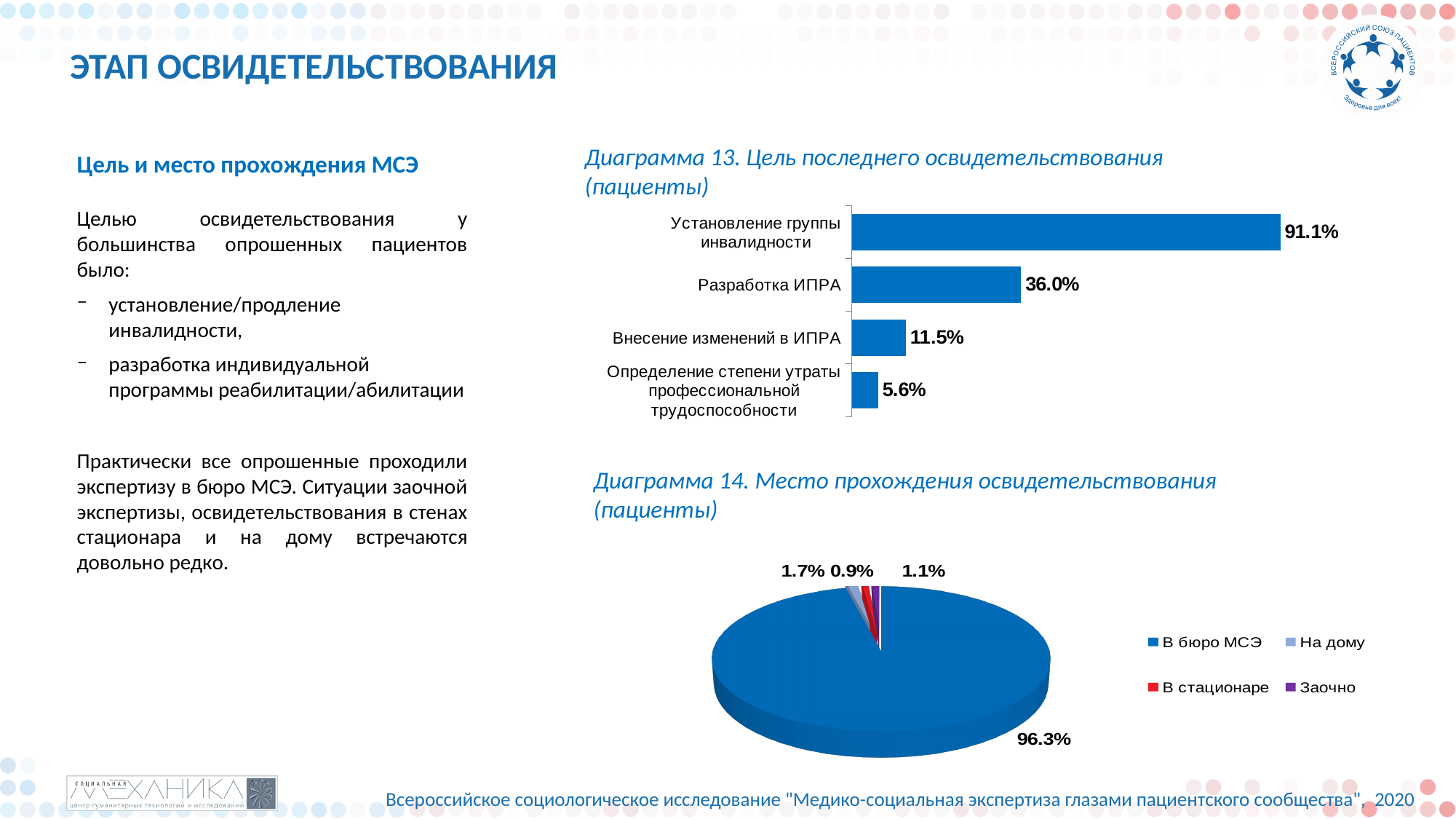
In Diagram 13 (Цель последнего освидетельствования), which is larger: Внесение изменений в ИПРА or Определение степени утраты профессиональной трудоспособности? Внесение изменений в ИПРА In Diagram 13 (Цель последнего освидетельствования), what is the difference between Установление группы инвалидности and Разработка ИПРА? 55.1% In Diagram 14 (Место прохождения освидетельствования), what share does В бюро МСЭ have? 96.3% In Diagram 13 (Цель последнего освидетельствования), what is the value for Внесение изменений в ИПРА? 11.5% In Diagram 13 (Цель последнего освидетельствования), which category has the lowest value? Определение степени утраты профессиональной трудоспособности In Diagram 13 (Цель последнего освидетельствования), which category has the highest value? Установление группы инвалидности In Diagram 13 (Цель последнего освидетельствования), what is the value for Разработка ИПРА? 36.0% In Diagram 13 (Цель последнего освидетельствования), what is the value for Установление группы инвалидности? 91.1% What kind of chart is Diagram 14 (Место прохождения освидетельствования)? Pie chart In Diagram 13 (Цель последнего освидетельствования), how many categories are shown? 4 What kind of chart is Diagram 13 (Цель последнего освидетельствования)? Bar chart In Diagram 14 (Место прохождения освидетельствования), how many entries does the legend list? 4